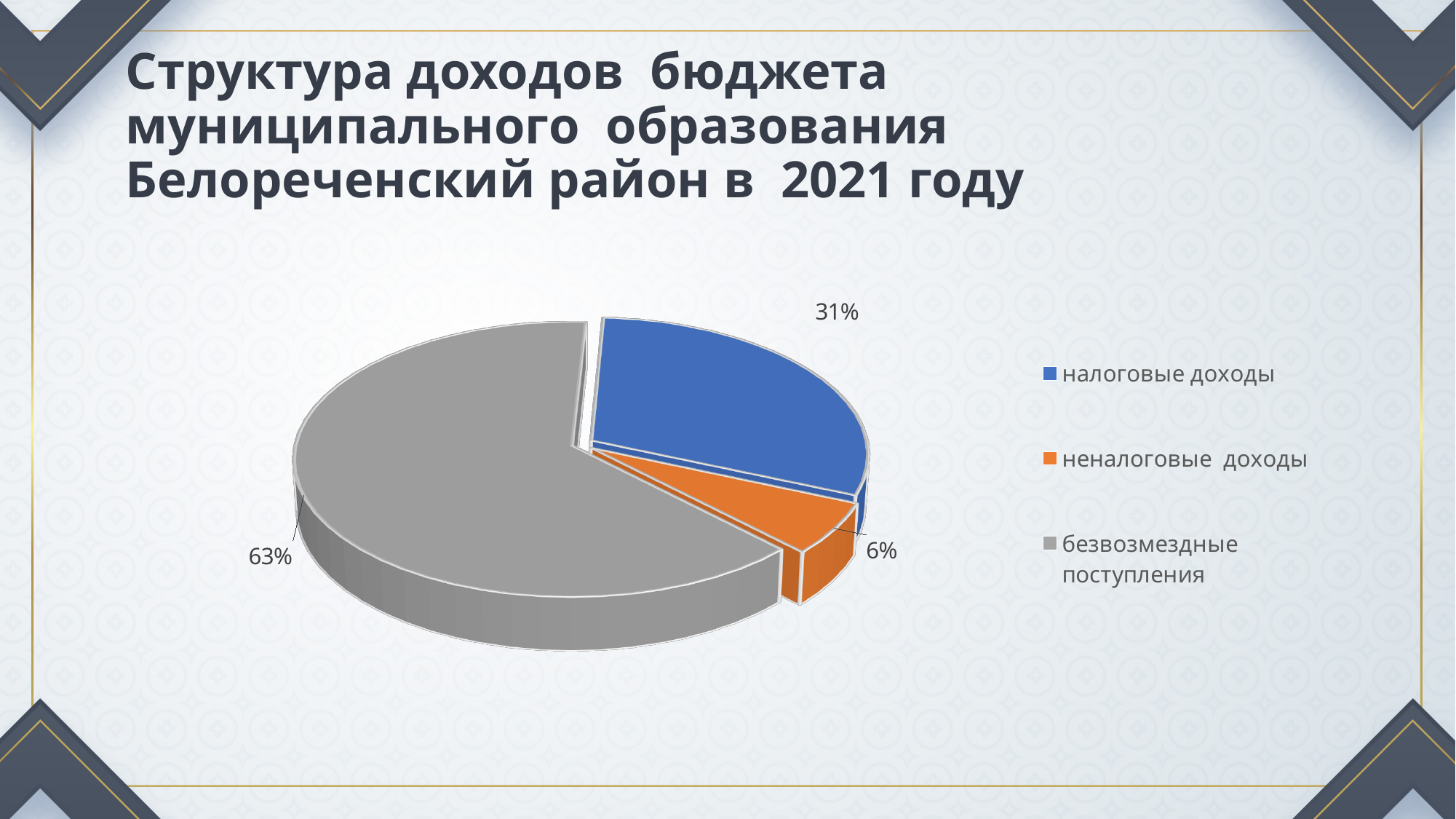
What is the difference in percentage points between безвозмездные поступления and налоговые доходы? 32 What colour is the slice for безвозмездные поступления? grey Which is larger: налоговые доходы or неналоговые доходы? налоговые доходы Which category has the largest slice of the pie? безвозмездные поступления What kind of chart is shown on the slide? pie chart Which category is shown in orange in the legend? неналоговые доходы What share of the pie does неналоговые доходы represent? 6% How many categories does the pie chart show? 3 What is the difference in percentage points between налоговые доходы and неналоговые доходы? 25 What share of the pie does налоговые доходы represent? 31% Which category has the smallest slice of the pie? неналоговые доходы What share of the pie does безвозмездные поступления represent? 63%